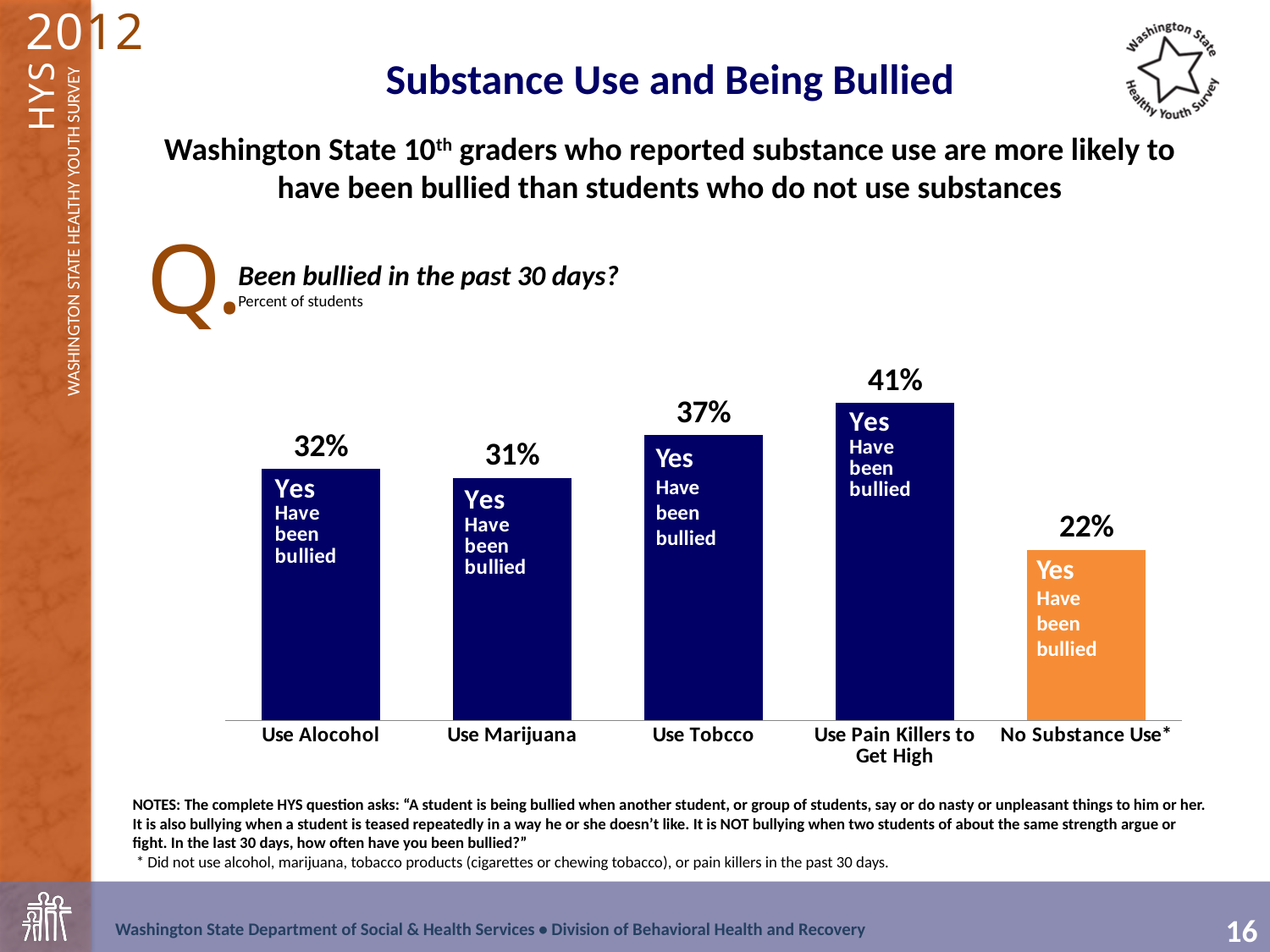
What percentage of students who use marijuana reported having been bullied? 31% What is the difference in percentage points between students who use tobacco and students who use alcohol? 5 What percentage of students who use alcohol reported having been bullied? 32% Which is larger: the percentage bullied among students who use tobacco or among students who use marijuana? Use Tobcco Which category has the highest percentage of students who have been bullied? Use Pain Killers to Get High What type of chart is shown on the slide? Bar chart What percentage of students who use tobacco reported having been bullied? 37% How many categories are shown in the chart? 5 What is the difference in percentage points between students who use pain killers to get high and students with no substance use? 19 What percentage of students who use pain killers to get high reported having been bullied? 41% Which category has the lowest percentage of students who have been bullied? No Substance Use* What percentage of students with no substance use reported having been bullied? 22%